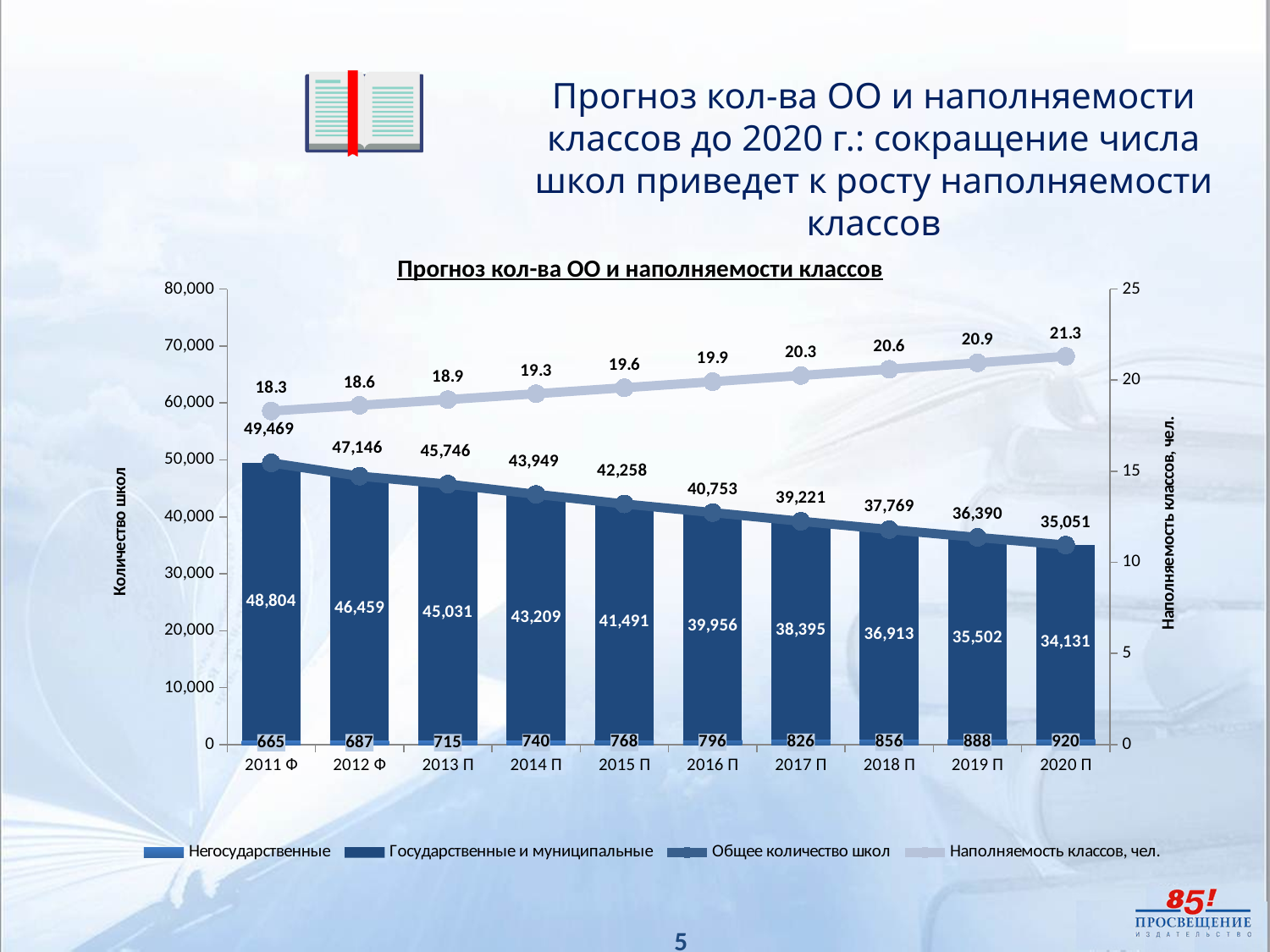
In which year is Общее количество школ lowest? 2020 П How many series does the legend list? 4 What is the value of Общее количество школ in 2015 П? 42,258 What is the value for Негосударственные in 2020 П? 920 Which is larger: Государственные и муниципальные in 2013 П or in 2016 П? 2013 П In which year is Наполняемость классов, чел. highest? 2020 П How many years are shown on the x axis? 10 What is the difference between Общее количество школ in 2011 Ф and 2020 П? 14,418 What is the value of Наполняемость классов, чел. in 2017 П? 20.3 What is the title of the chart? Прогноз кол-ва ОО и наполняемости классов What is the value for Государственные и муниципальные in 2011 Ф? 48,804 Does Наполняемость классов, чел. rise or fall from 2011 Ф to 2020 П? rise